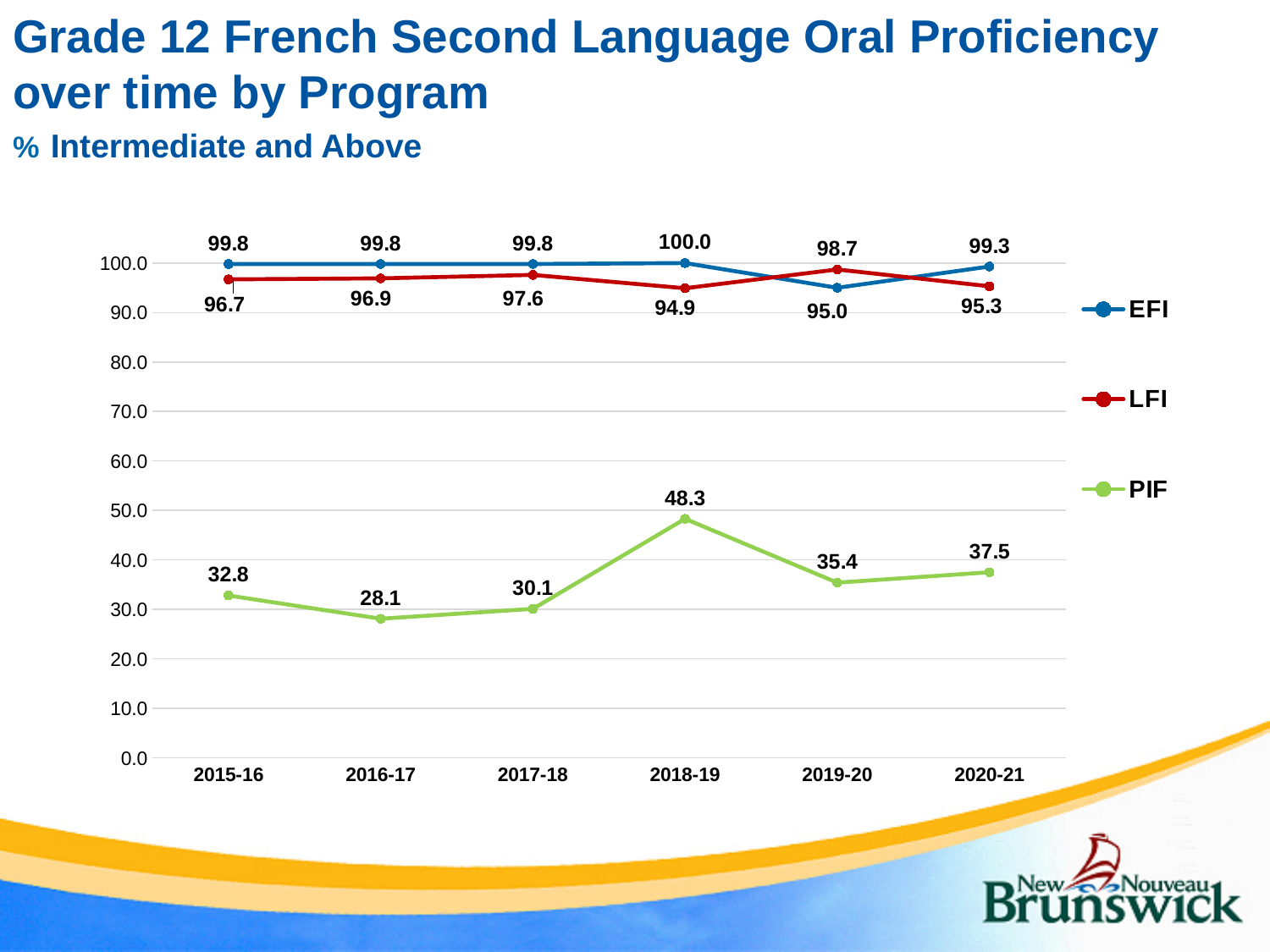
What is the value for LFI in 2017-18? 97.6 Which is larger in 2019-20, EFI or LFI? LFI How many series does the legend list? 3 What is the value for PIF in 2018-19? 48.3 In which year is the EFI value highest? 2018-19 What kind of chart is shown on the slide? line chart What is the difference between the EFI and PIF values in 2020-21? 61.8 In which year is the PIF value lowest? 2016-17 What is the value for EFI in 2019-20? 95.0 How many school years are shown on the x axis? 6 Is the value for PIF in 2018-19 greater or less than 40.0? greater Does the PIF value rise or fall from 2016-17 to 2018-19? rise